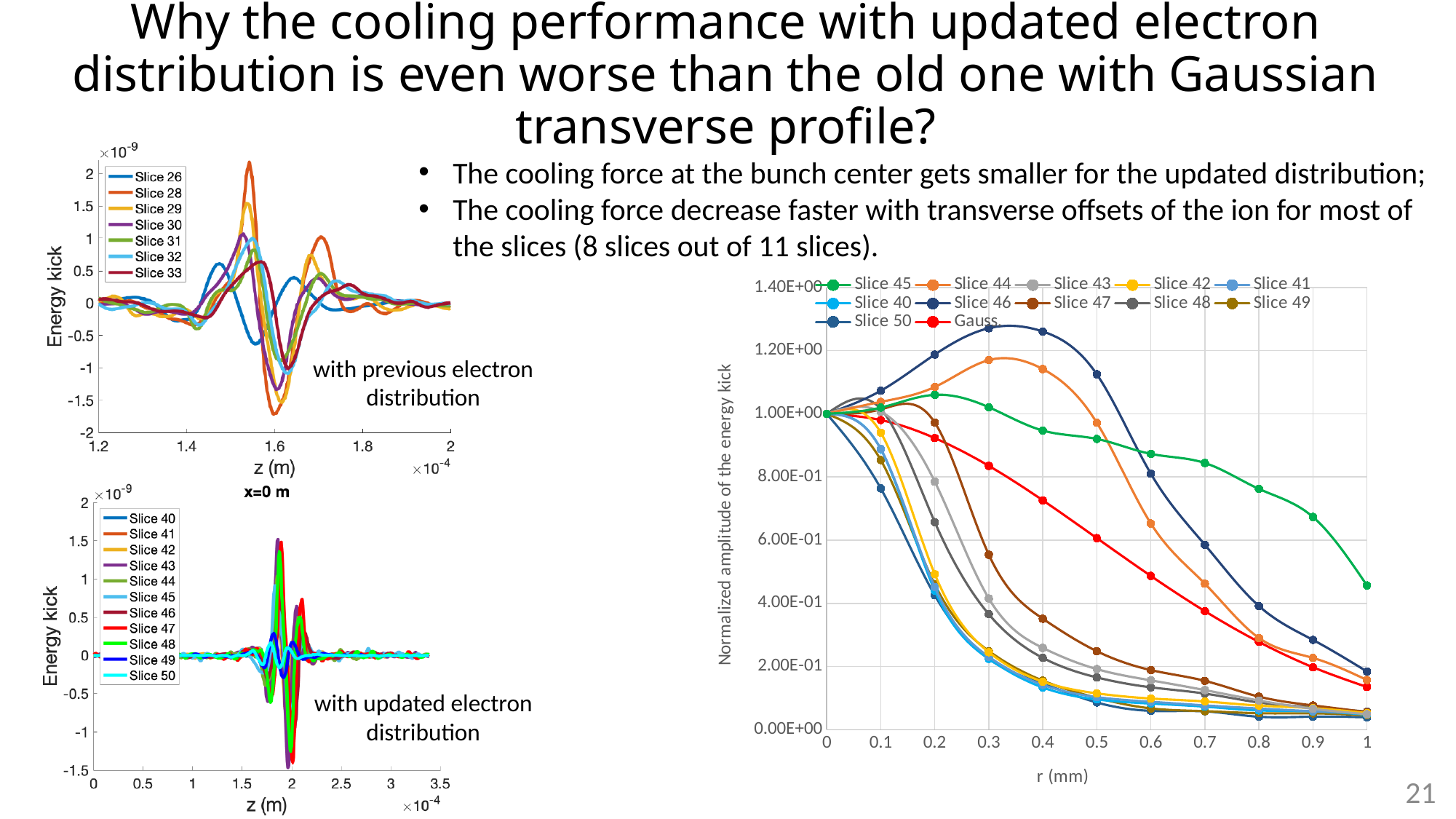
What is the x-axis label of the bottom-left chart (with updated electron distribution)? z (m) In the right-hand chart (normalized amplitude vs r), is the value of Gauss. at r = 1 greater or less than 2.00E-01? less In the right-hand chart (normalized amplitude vs r), how many r values are plotted for each series? 11 What kind of chart is the chart on the right showing normalized amplitude of the energy kick versus r (mm)? line chart In the right-hand chart (normalized amplitude vs r), what is the value of every series at r = 0? 1.00E+00 In the right-hand chart (normalized amplitude vs r), is the value of Slice 40 at r = 0.2 greater or less than 6.00E-01? less How many series does the legend of the right-hand chart (normalized amplitude vs r) list? 12 In the right-hand chart (normalized amplitude vs r), which series has the highest value at r = 1? Slice 45 In the right-hand chart (normalized amplitude vs r), is the value of Slice 46 at r = 0.3 greater or less than 1.20E+00? greater How many series does the legend of the top-left chart (with previous electron distribution) list? 7 In the right-hand chart (normalized amplitude vs r), which is larger at r = 1: Slice 45 or Gauss.? Slice 45 In the right-hand chart (normalized amplitude vs r), does the Gauss. series rise or fall as r increases from 0 to 1? fall